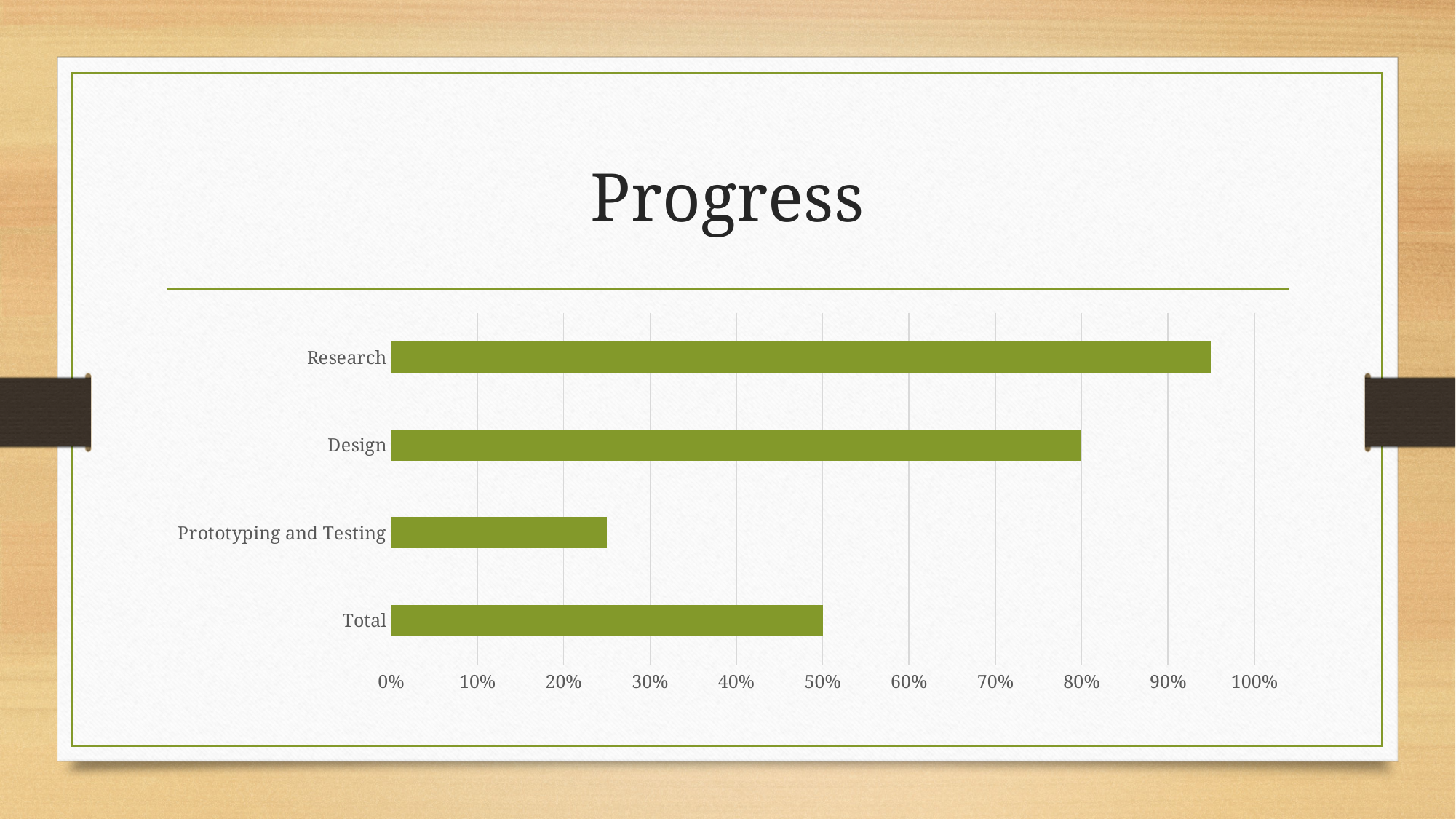
Which category has the lowest value? Prototyping and Testing Which is larger, the value for Design or the value for Total? Design What kind of chart is shown on the slide? bar chart What is the difference between the value for Design and the value for Total? 30% How many categories are plotted in the chart? 4 What is the highest value shown on the horizontal axis? 100% Is the value for Research greater or less than 90%? greater What is the value for Design? 80% What is the title of the slide containing the chart? Progress What is the value for Total? 50% Which category has the highest value? Research Is the value for Prototyping and Testing greater or less than 30%? less